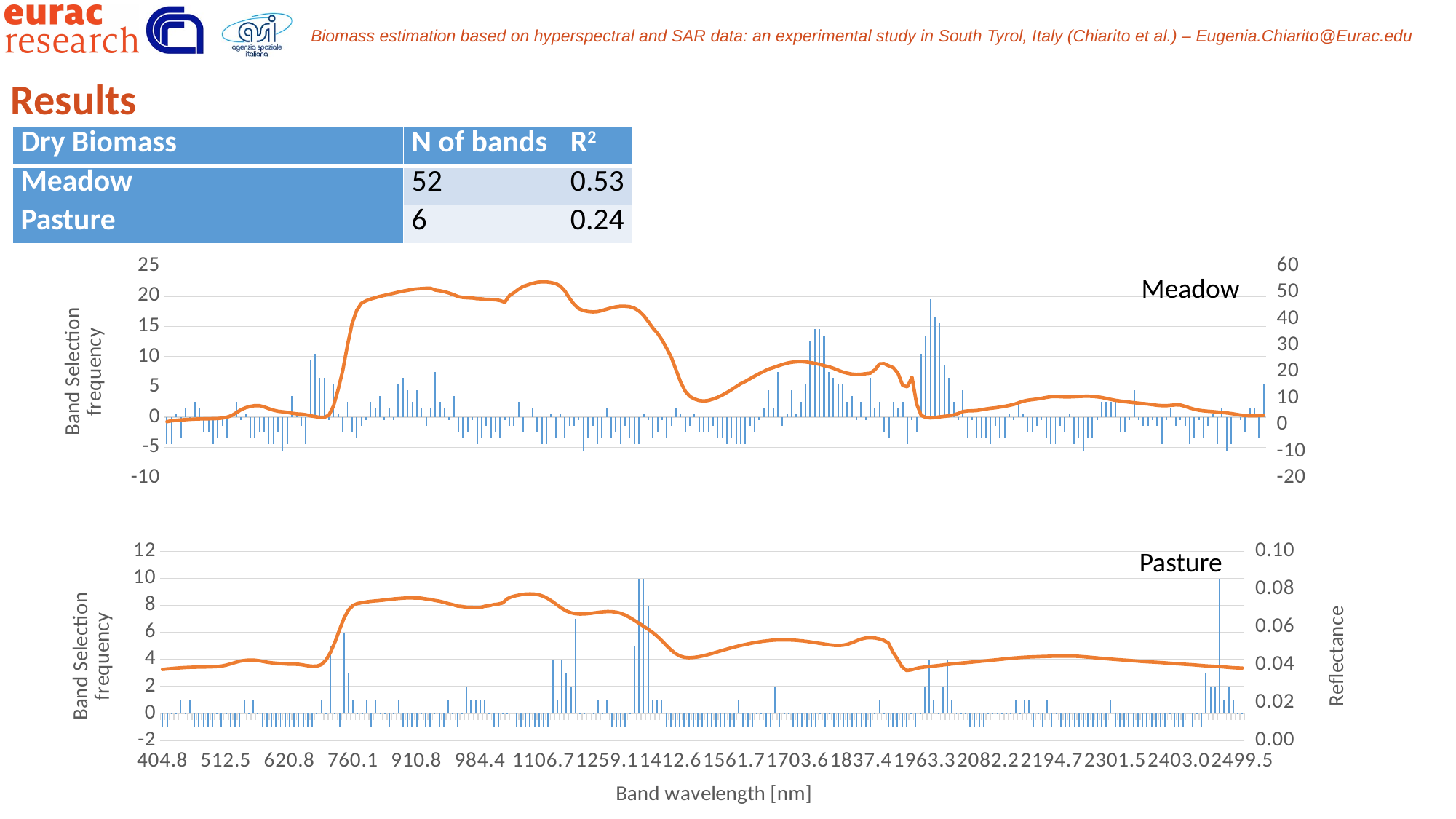
What is the label of the horizontal axis shared by the two charts? Band wavelength [nm] What kind of chart is the Meadow chart at the top of the slide? A combined bar and line chart On the Meadow chart, is the tallest blue band selection frequency bar (near 1963.3 nm) greater or less than 15? greater On the Pasture chart, is the highest point of the orange reflectance line greater or less than 0.06 on the right axis? greater What is the label of the left vertical axis on the Pasture chart? Band Selection frequency How many wavelength labels are shown along the horizontal axis of the Pasture chart? 18 On the Meadow chart, is the orange reflectance line at 404.8 nm greater or less than 10 on the right axis? less On the Meadow chart, does the orange reflectance line rise or fall between 620.8 nm and 760.1 nm? rise On the Meadow chart, does the orange reflectance line rise or fall between 1106.7 nm and 1412.6 nm? fall What is the maximum value shown on the left vertical axis of the Meadow chart? 25